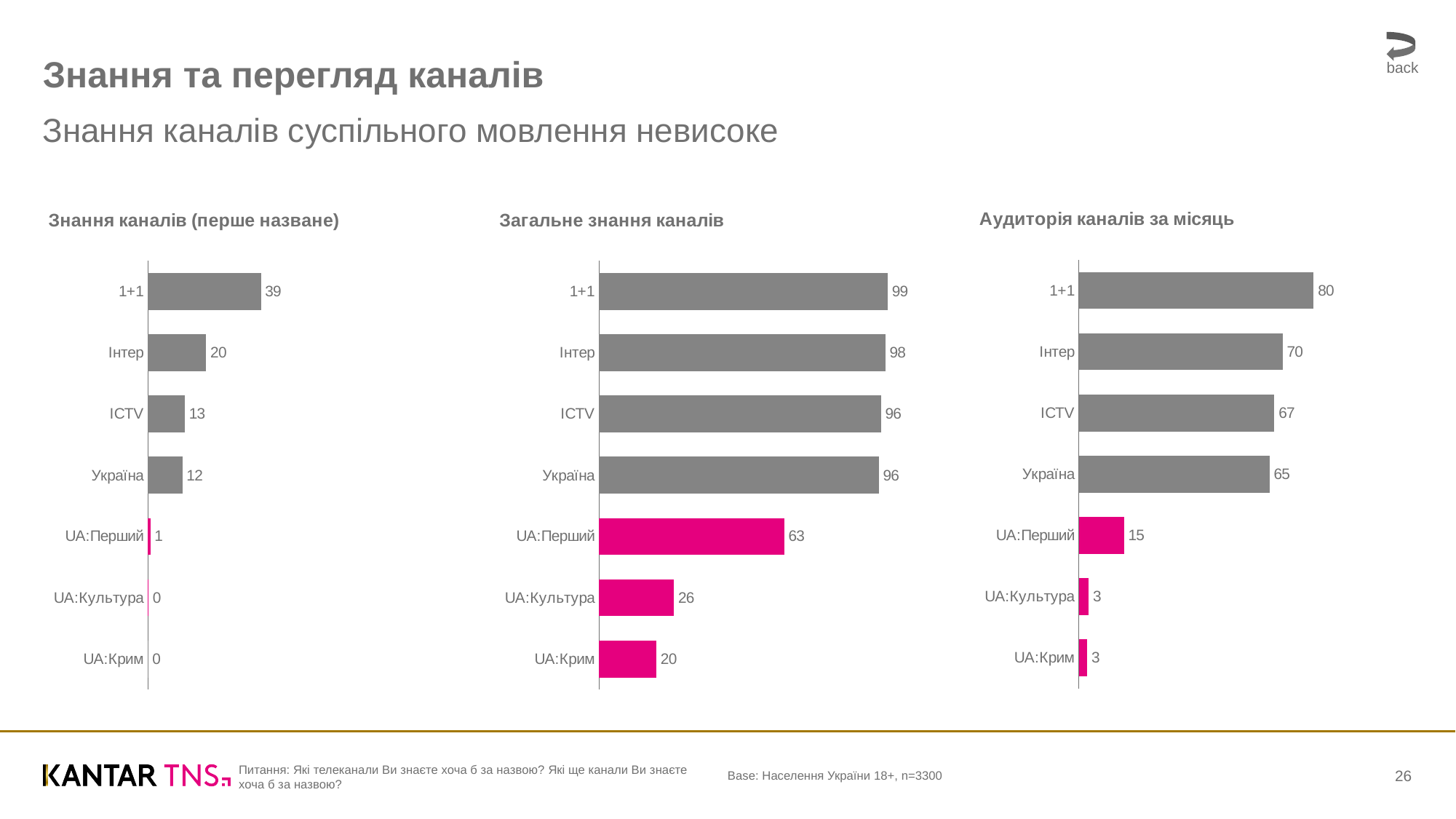
How many charts are shown on the slide? 3 In the chart titled 'Загальне знання каналів', which channel has the lowest value? UA:Крим How many channels are shown in the chart titled 'Знання каналів (перше назване)'? 7 In the chart titled 'Аудиторія каналів за місяць', what is the difference between the values for ICTV and Україна? 2 In the chart titled 'Загальне знання каналів', what is the value for UA:Перший? 63 In the chart titled 'Знання каналів (перше назване)', which is larger, the value for Інтер or the value for ICTV? Інтер In the chart titled 'Знання каналів (перше назване)', what is the value for 1+1? 39 In the chart titled 'Знання каналів (перше назване)', which channels have a value of 0? UA:Культура and UA:Крим In the chart titled 'Аудиторія каналів за місяць', what is the value for Інтер? 70 What type of chart is the chart titled 'Загальне знання каналів'? Bar chart In the chart titled 'Загальне знання каналів', what is the difference between the values for 1+1 and UA:Перший? 36 In the chart titled 'Аудиторія каналів за місяць', which channel has the highest value? 1+1